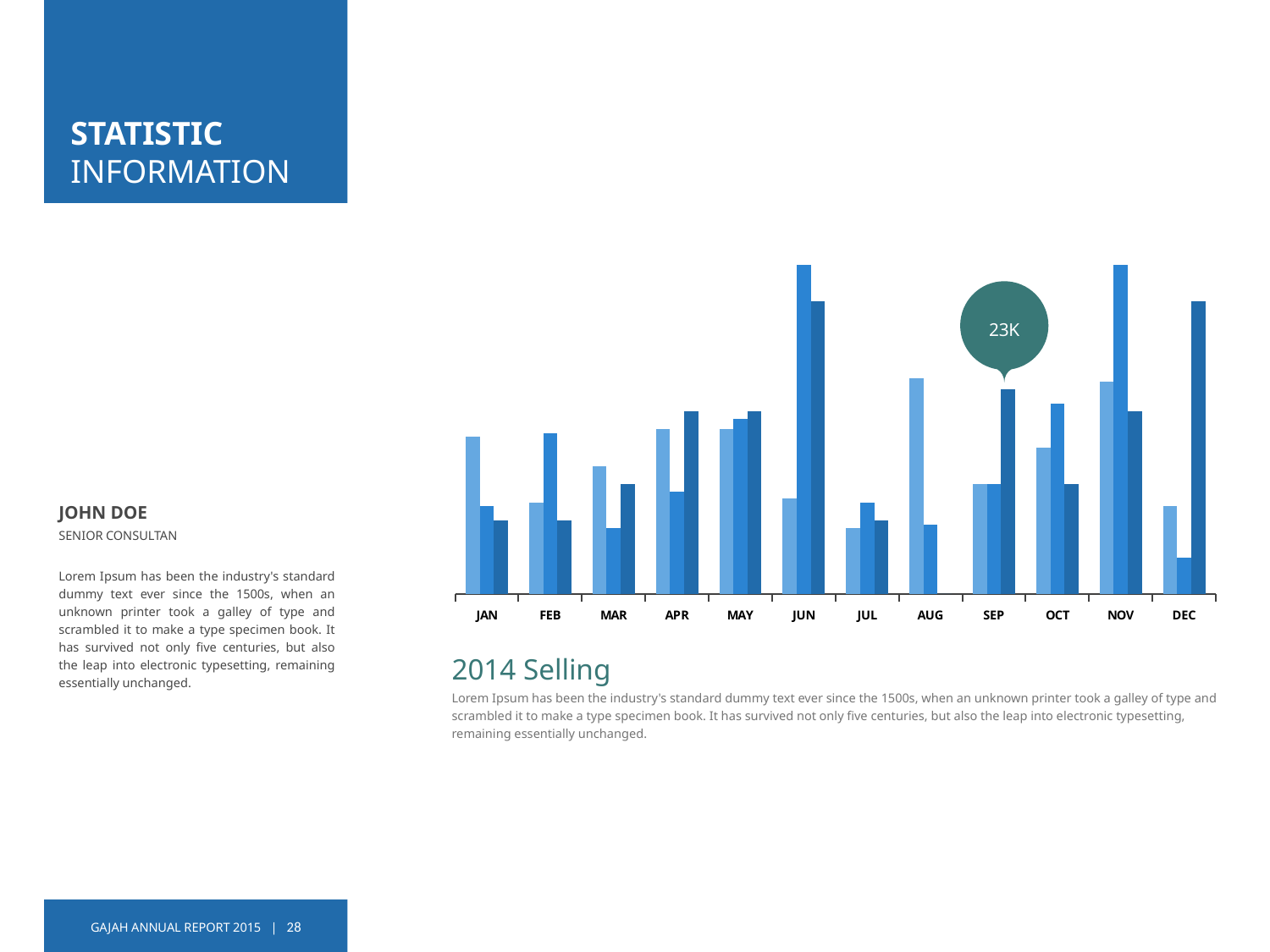
What kind of chart is shown on the slide? bar chart What value does the callout above the SEP bars show? 23K Which month has the shortest bar in the chart? DEC Is the light blue bar taller in AUG or in JAN? AUG How many months are shown along the x axis of the chart? 12 Is the light blue bar taller in JUL or in NOV? NOV Is the medium blue bar taller in FEB or in MAR? FEB What is the title shown below the chart? 2014 Selling How many bars are plotted for each month in the chart? 3